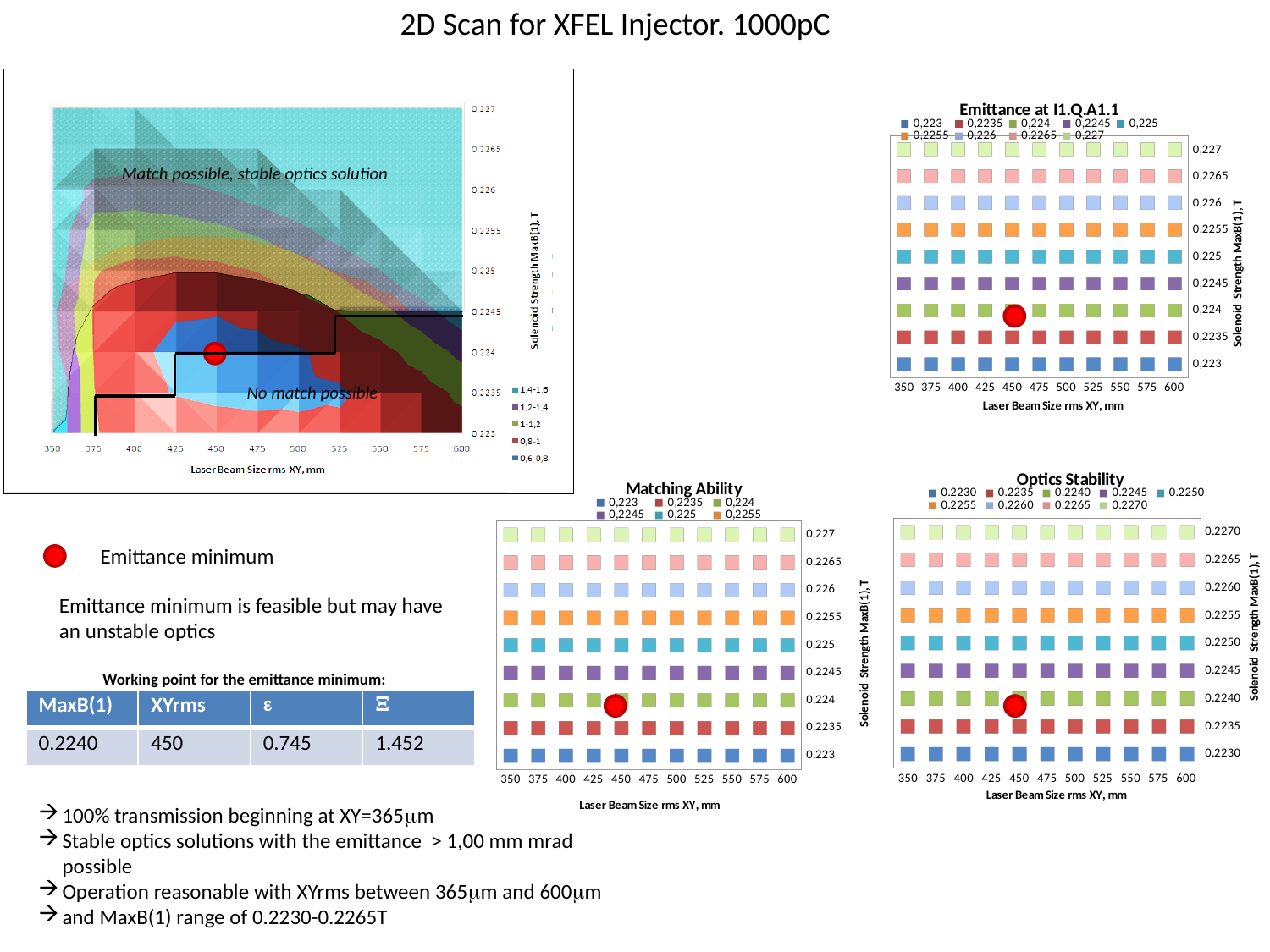
How many series does the legend of the 'Matching Ability' chart list? 6 In the 'Matching Ability' chart, at which laser beam size (x axis) is the red emittance-minimum marker placed? 450 How many series does the legend of the 'Emittance at I1.Q.A1.1' chart list? 9 In the 'Optics Stability' chart, at which solenoid strength (y axis) is the red emittance-minimum marker placed? 0.2240 What is the y-axis title of the 'Optics Stability' chart? Solenoid Strength MaxB(1), T How many laser beam size values are marked on the x axis of the 'Optics Stability' chart? 11 What is the x-axis title of the 'Emittance at I1.Q.A1.1' chart? Laser Beam Size rms XY, mm What kind of chart is the 'Emittance at I1.Q.A1.1' chart? scatter chart How many solenoid strength levels are marked on the y axis of the 'Matching Ability' chart? 9 How many series does the legend of the 'Optics Stability' chart list? 9 What is the lowest laser beam size value shown on the x axis of the 'Matching Ability' chart? 350